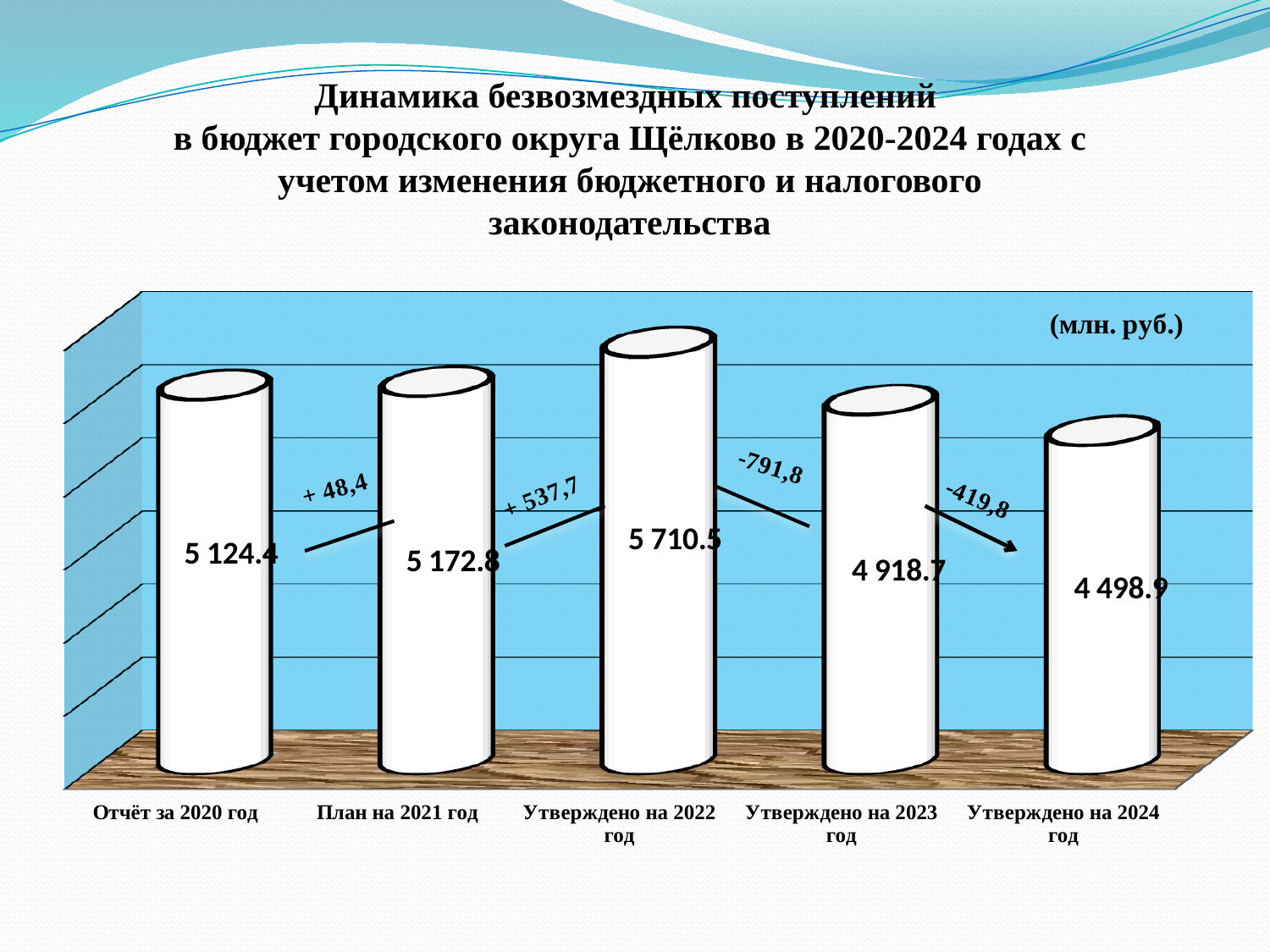
What kind of chart is shown on the slide? Bar chart What is the difference between the values for «Утверждено на 2022 год» and «Утверждено на 2024 год»? 1 211.6 Which category has the lowest value? Утверждено на 2024 год What is the value for «Утверждено на 2024 год»? 4 498.9 What unit of measurement is indicated on the chart? млн. руб. How many categories are shown on the chart? 5 What is the value for «Отчёт за 2020 год»? 5 124.4 What is the difference between the values for «Утверждено на 2022 год» and «Утверждено на 2023 год»? 791.8 Which category has the highest value? Утверждено на 2022 год What is the value for «План на 2021 год»? 5 172.8 Which is larger: the value for «Утверждено на 2023 год» or «Утверждено на 2024 год»? Утверждено на 2023 год What is the value for «Утверждено на 2022 год»? 5 710.5